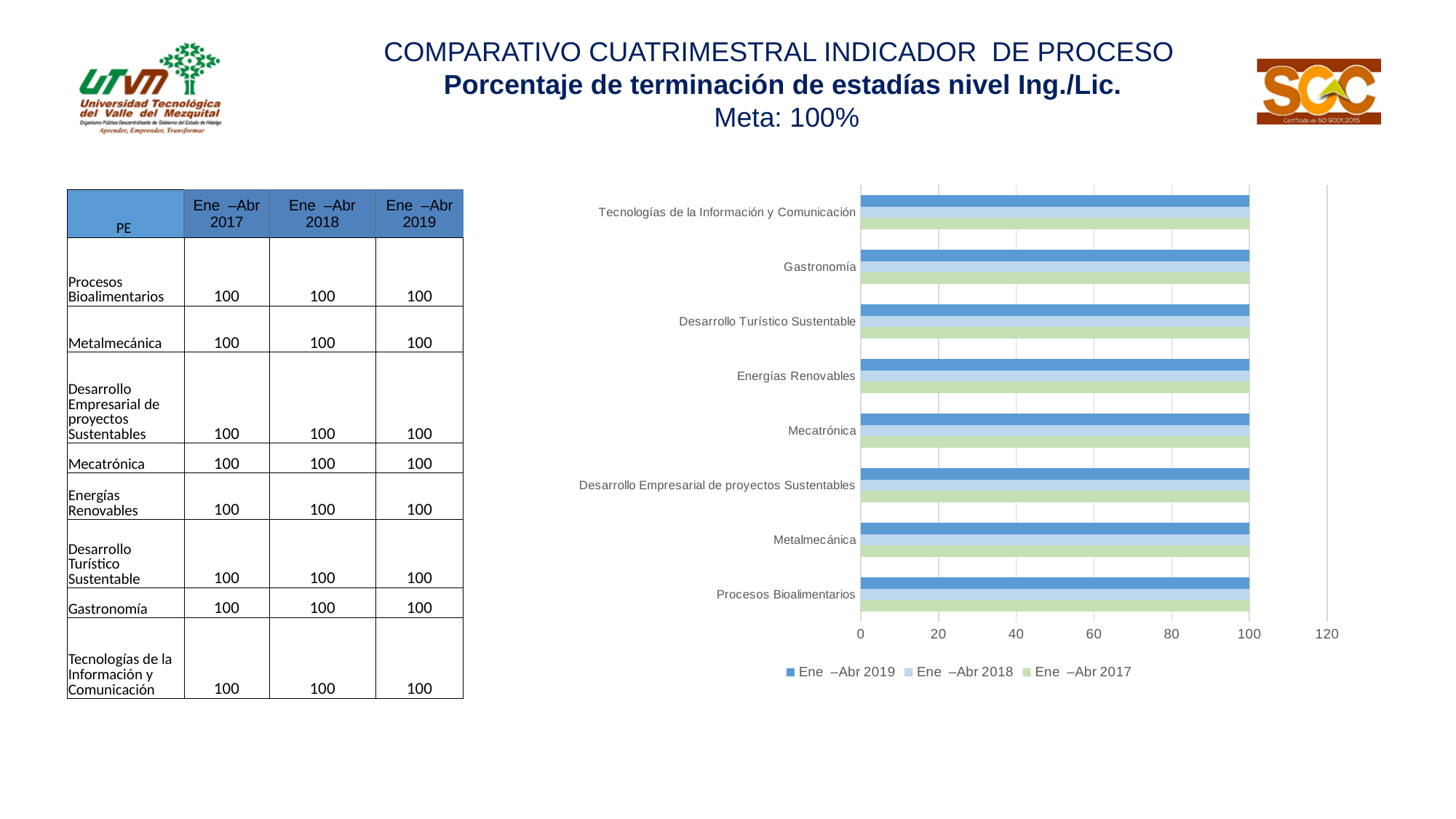
How many categories (programs) does the chart show? 8 Is the value for Energías Renovables in the Ene –Abr 2018 series greater or less than 120? less What is the value for Mecatrónica in the Ene –Abr 2019 series? 100 Which series is listed first in the chart legend? Ene –Abr 2019 Is the value for Procesos Bioalimentarios in the Ene –Abr 2019 series greater or less than 80? greater How many series does the chart legend list? 3 What is the value for Tecnologías de la Información y Comunicación in the Ene –Abr 2018 series? 100 What kind of chart is shown on the slide? bar chart What is the value for Gastronomía in the Ene –Abr 2017 series? 100 What is the highest value shown on the horizontal axis of the chart? 120 Do the values for Desarrollo Turístico Sustentable change between the Ene –Abr 2017 and Ene –Abr 2019 series? No, both are 100 What is the difference between the Ene –Abr 2019 and Ene –Abr 2017 values for Metalmecánica? 0